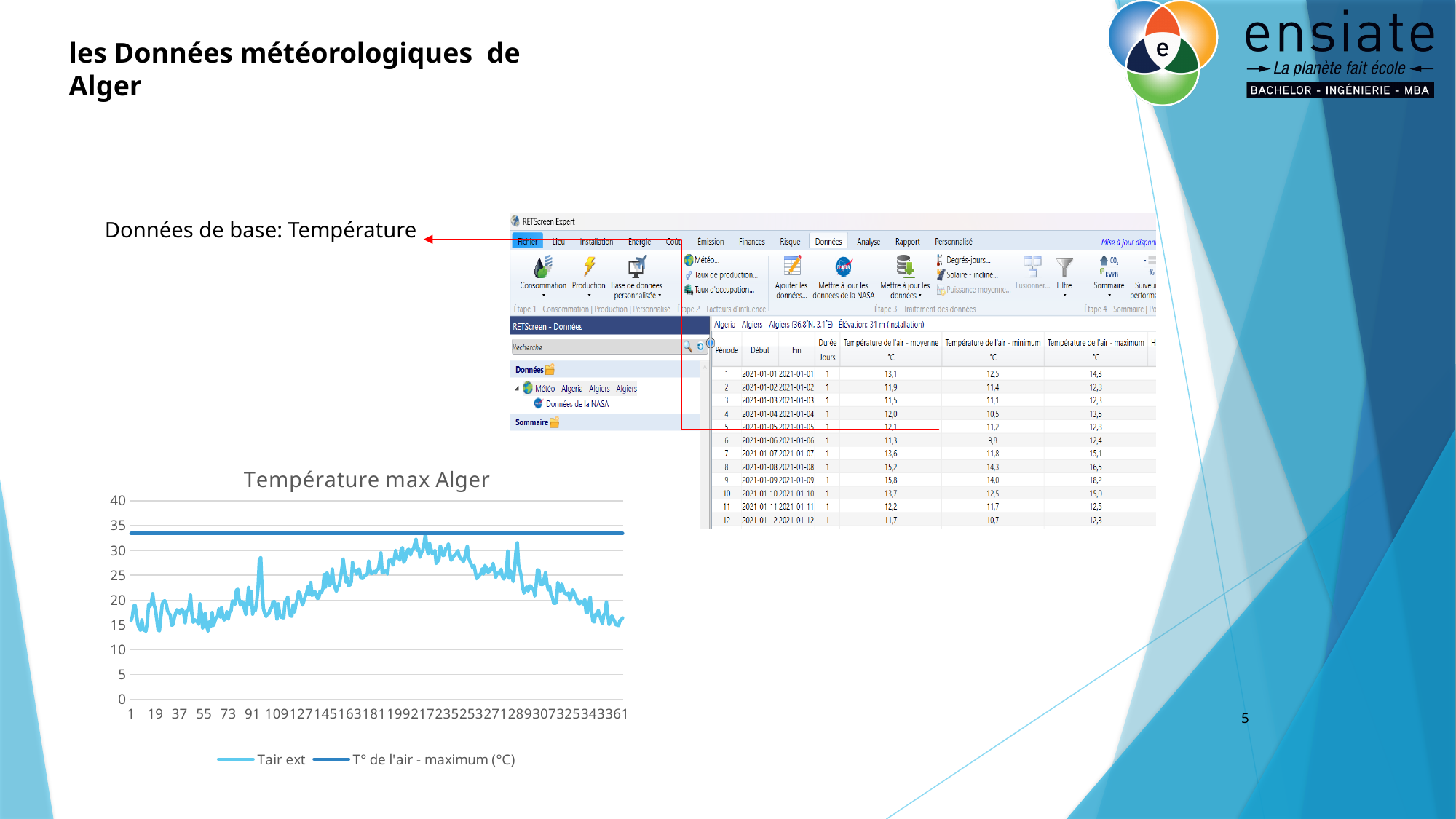
In the "Température max Alger" chart, do the "Tair ext" values generally rise or fall between x = 253 and x = 361? fall In the "Température max Alger" chart, is the value of the "T° de l'air - maximum (°C)" line greater or less than 35? less How many series does the legend of the "Température max Alger" chart list? 2 How many tick labels are shown on the x axis of the "Température max Alger" chart? 21 In the "Température max Alger" chart, is the value of "Tair ext" at x = 361 greater or less than 25? less What kind of chart is "Température max Alger"? line chart What are the two legend entries of the "Température max Alger" chart? Tair ext; T° de l'air - maximum (°C) In the "Température max Alger" chart, is the value of the "T° de l'air - maximum (°C)" line greater or less than 30? greater What is the title of the chart at the bottom left of the slide? Température max Alger In the "Température max Alger" chart, do the "Tair ext" values generally rise or fall between x = 1 and x = 199? rise In the "Température max Alger" chart, which series has the higher value at x = 1: "Tair ext" or "T° de l'air - maximum (°C)"? T° de l'air - maximum (°C)